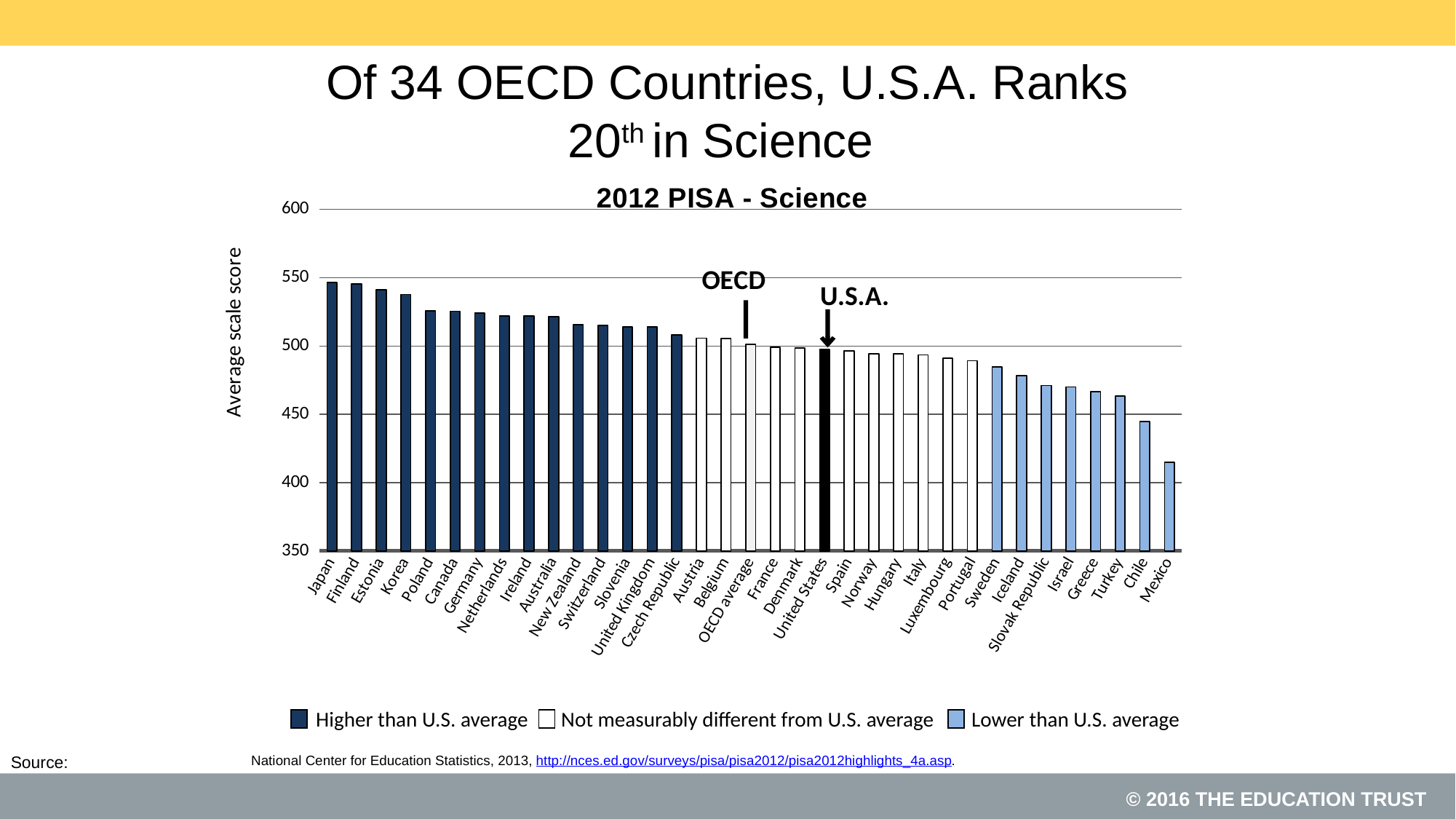
Which has a higher average scale score, Korea or Poland? Korea Which country has the lowest average scale score in the chart? Mexico Is the value for Mexico greater or less than 450? less What kind of chart is shown on the slide? bar chart Which country has the highest average scale score in the chart? Japan Is the value for Finland greater or less than 550? less Which has a higher average scale score, Greece or Chile? Greece Do the values rise or fall moving from left to right along the x axis? fall Is the value for Turkey greater or less than 500? less How many bars are plotted in the chart? 35 How many entries does the legend list? 3